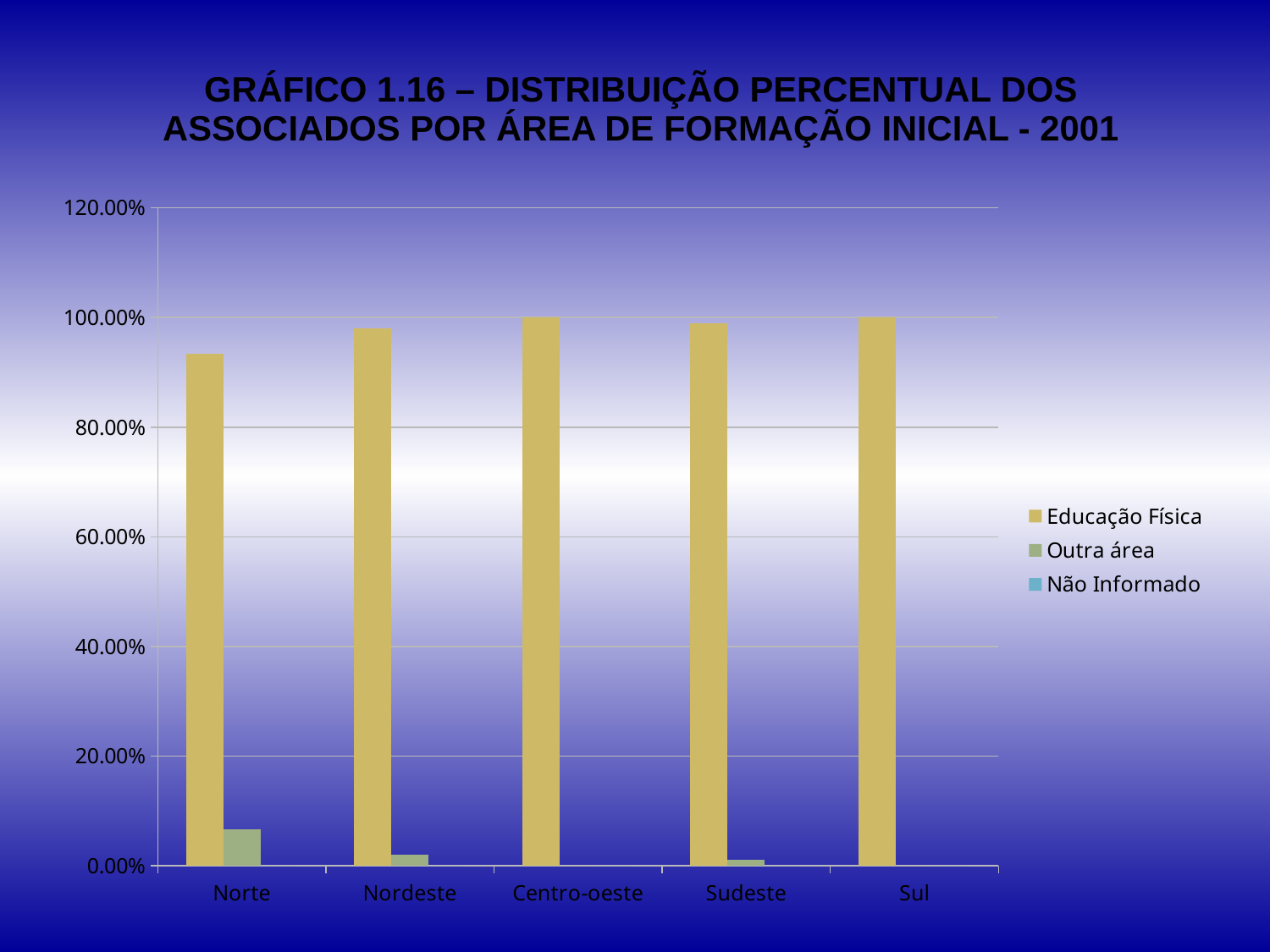
What kind of chart is shown on the slide? bar chart What year is referenced in the chart title? 2001 Is the value for Outra área in Norte greater or less than 20.00%? less Which region has the highest value for Outra área? Norte Is the value for Educação Física in Norte greater or less than 80.00%? greater Which is larger, the Outra área value for Norte or for Sudeste? Norte Is the value for Educação Física in Nordeste greater or less than 100.00%? less How many series does the legend list? 3 Which is larger, the Educação Física value for Norte or for Nordeste? Nordeste What are the three series listed in the legend? Educação Física, Outra área, Não Informado How many regions (categories) are shown on the x axis? 5 Which region has the lowest value for Educação Física? Norte